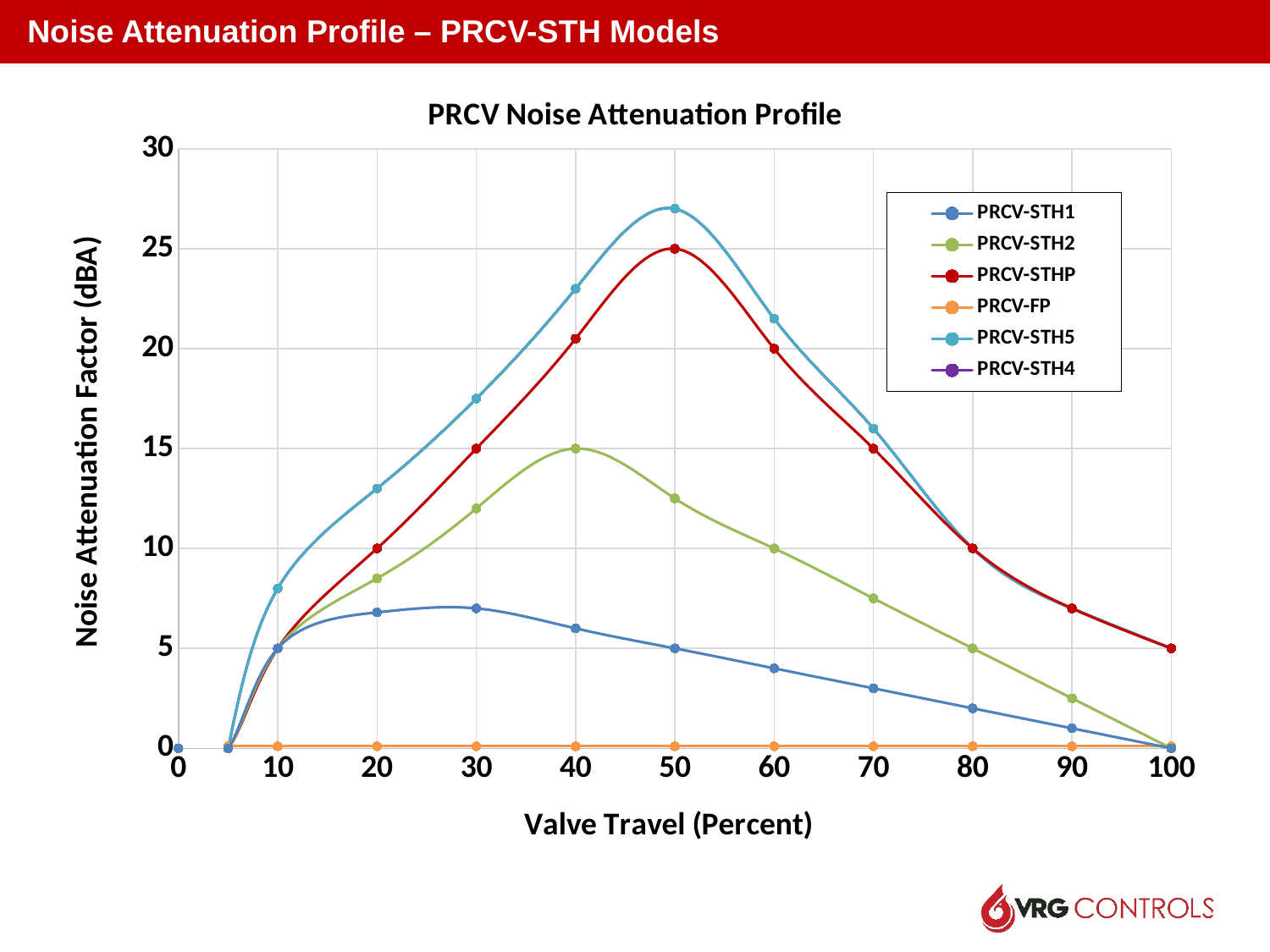
Does the PRCV-STH1 series rise or fall between 50 and 100 percent valve travel? Fall What is the label of the y axis? Noise Attenuation Factor (dBA) How many series does the legend list? 6 What is the value of PRCV-STHP at 100 percent valve travel? 5 Is the value for PRCV-STH1 at 30 percent valve travel greater or less than 5? greater What is the value of PRCV-STHP at 50 percent valve travel? 25 What kind of chart is shown on the slide? Line chart What is the value of PRCV-STH2 at 40 percent valve travel? 15 Is the value for PRCV-STH5 at 50 percent valve travel greater or less than 25? greater What is the title of the chart? PRCV Noise Attenuation Profile At 40 percent valve travel, which is larger, PRCV-STH5 or PRCV-STH2? PRCV-STH5 Which series has the highest value at 50 percent valve travel? PRCV-STH5